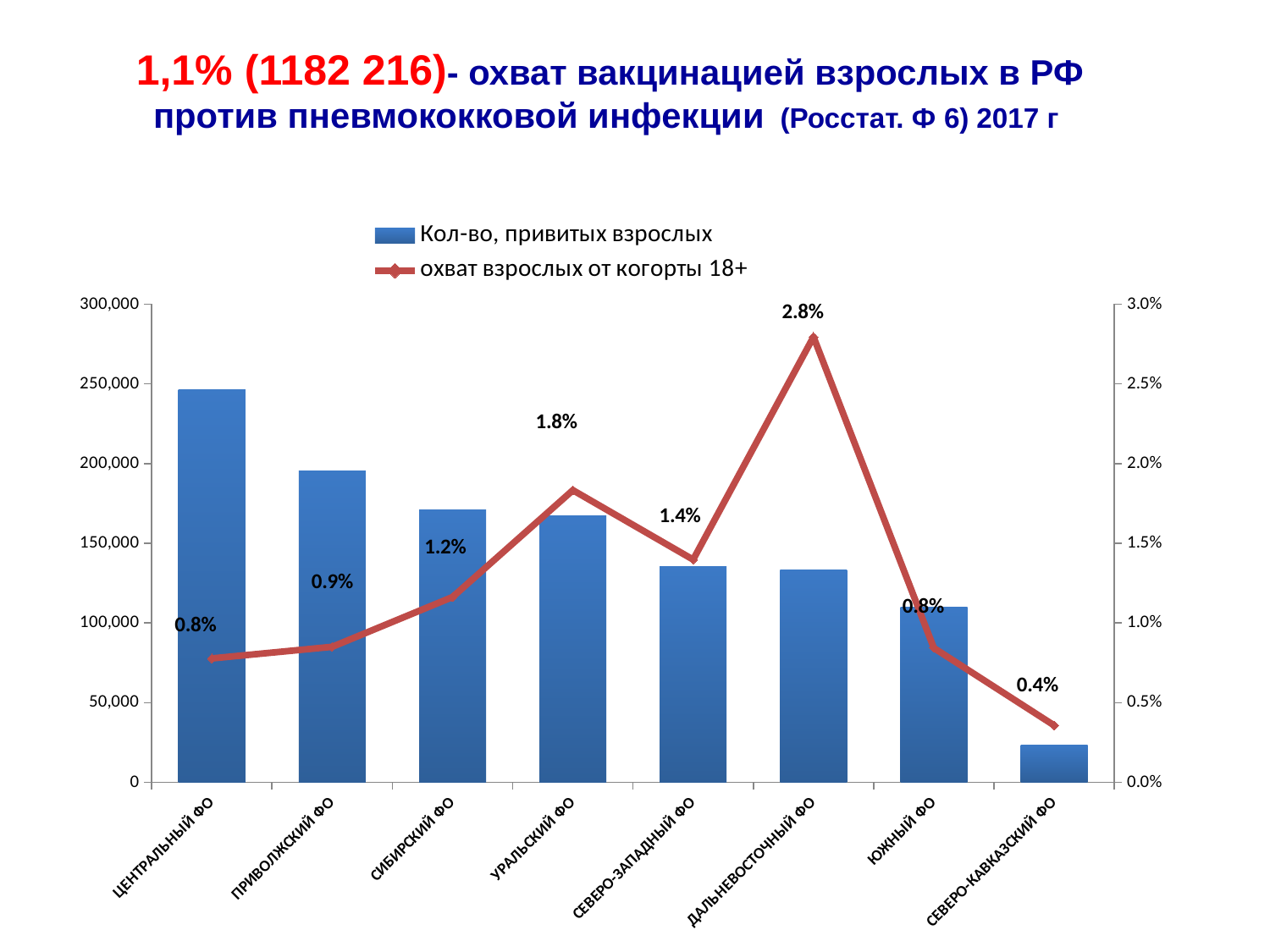
How many series does the legend list? 2 Is the number of vaccinated adults (bar) for Северо-Кавказский ФО greater or less than 50,000? less What kind of chart is shown on the slide? Combined bar chart and line chart What is the adult coverage value shown for Уральский ФО? 1.8% How many federal districts are shown on the x axis? 8 Is the number of vaccinated adults (bar) for Центральный ФО greater or less than 200,000? greater Which federal district has the lowest adult coverage percentage? Северо-Кавказский ФО Which federal district has the highest adult coverage percentage? Дальневосточный ФО What is the difference in coverage between Дальневосточный ФО (2.8%) and Уральский ФО (1.8%)? 1.0% Which has the higher coverage percentage: Сибирский ФО or Северо-Западный ФО? Северо-Западный ФО What is the adult coverage (охват взрослых от когорты 18+) for Дальневосточный ФО? 2.8% Which federal district has the tallest bar for number of vaccinated adults? Центральный ФО